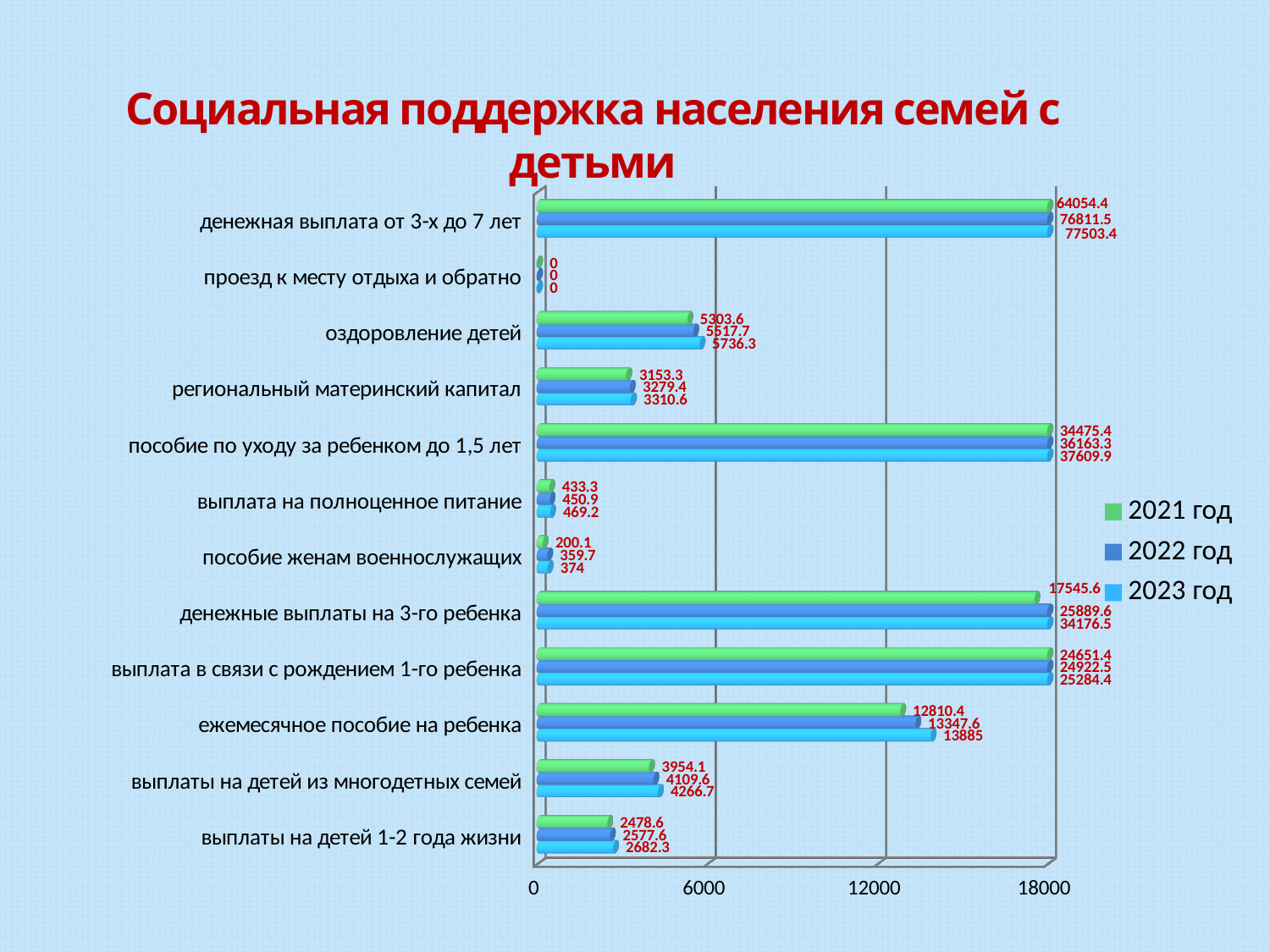
What kind of chart is shown on the slide? bar chart What is the difference between the 2023 год and 2021 год values for «денежные выплаты на 3-го ребенка»? 16630.9 What is the title of the slide? Социальная поддержка населения семей с детьми How many categories are shown on the chart? 12 Which category has the lowest value for 2021 год? проезд к месту отдыха и обратно What is the value for 2021 год for «денежные выплаты на 3-го ребенка»? 17545.6 What is the value for 2022 год for «ежемесячное пособие на ребенка»? 13347.6 How many series does the legend list? 3 What is the value for 2023 год for «пособие женам военнослужащих»? 374 What is the value for 2023 год for «денежная выплата от 3-х до 7 лет»? 77503.4 Which category has the highest value for 2023 год? денежная выплата от 3-х до 7 лет Which is larger for «оздоровление детей»: the 2021 год value or the 2023 год value? 2023 год